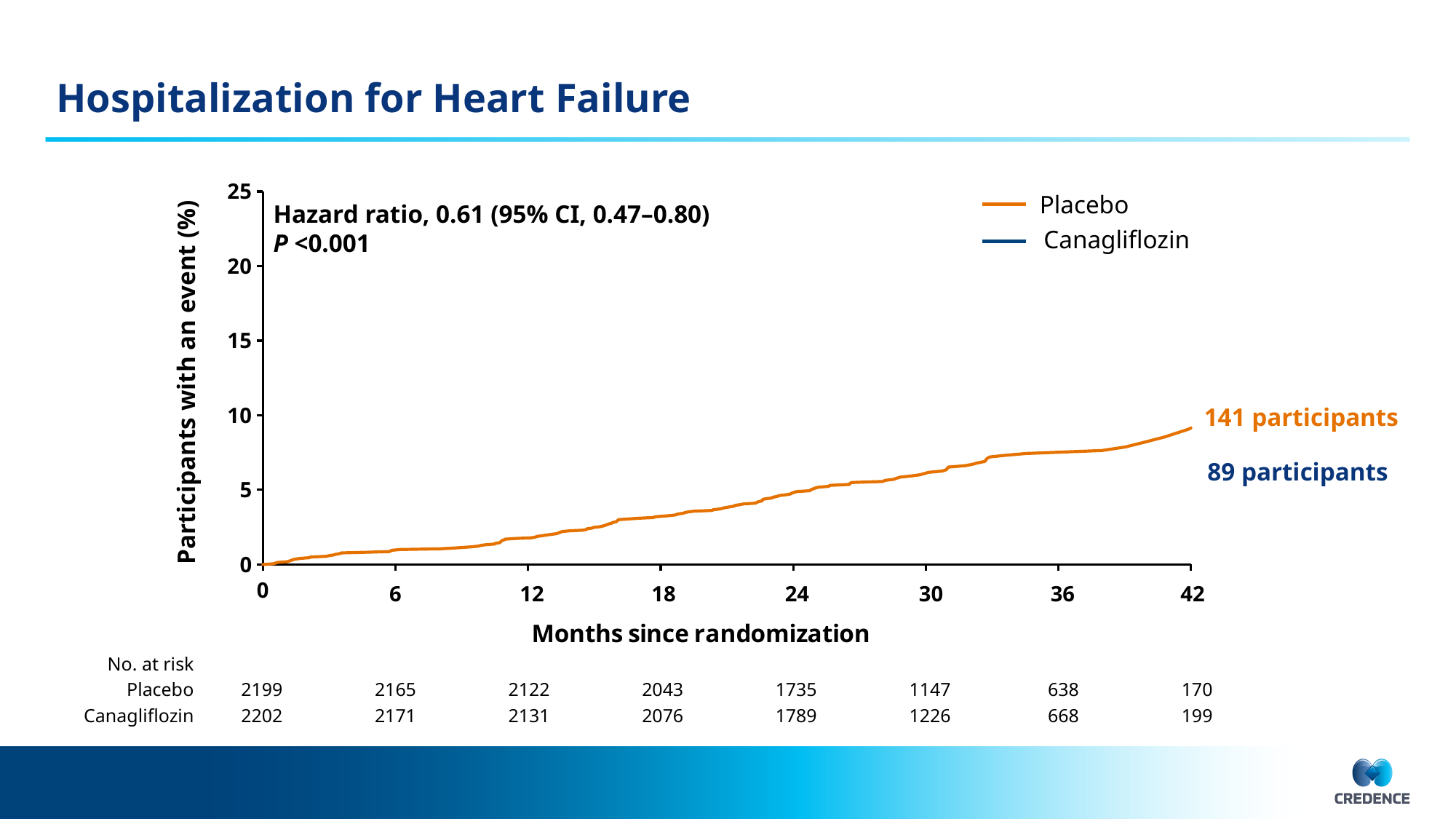
What is the number at risk for Canagliflozin at 42 months? 199 Does the Placebo curve rise or fall as months since randomization increase? rise How many participants had an event in the Canagliflozin group, according to the label on the chart? 89 participants Which series is drawn in orange according to the legend? Placebo What is the title of the chart on the slide? Hospitalization for Heart Failure Is the Placebo curve at 42 months greater or less than 10%? less How many participants had an event in the Placebo group, according to the label on the chart? 141 participants How many series does the legend list? 2 What hazard ratio is printed on the chart? 0.61 (95% CI, 0.47–0.80) What is the difference between the number at risk for Canagliflozin and Placebo at 24 months? 54 What kind of chart is shown on the slide? line chart What is the number at risk for Placebo at 0 months? 2199